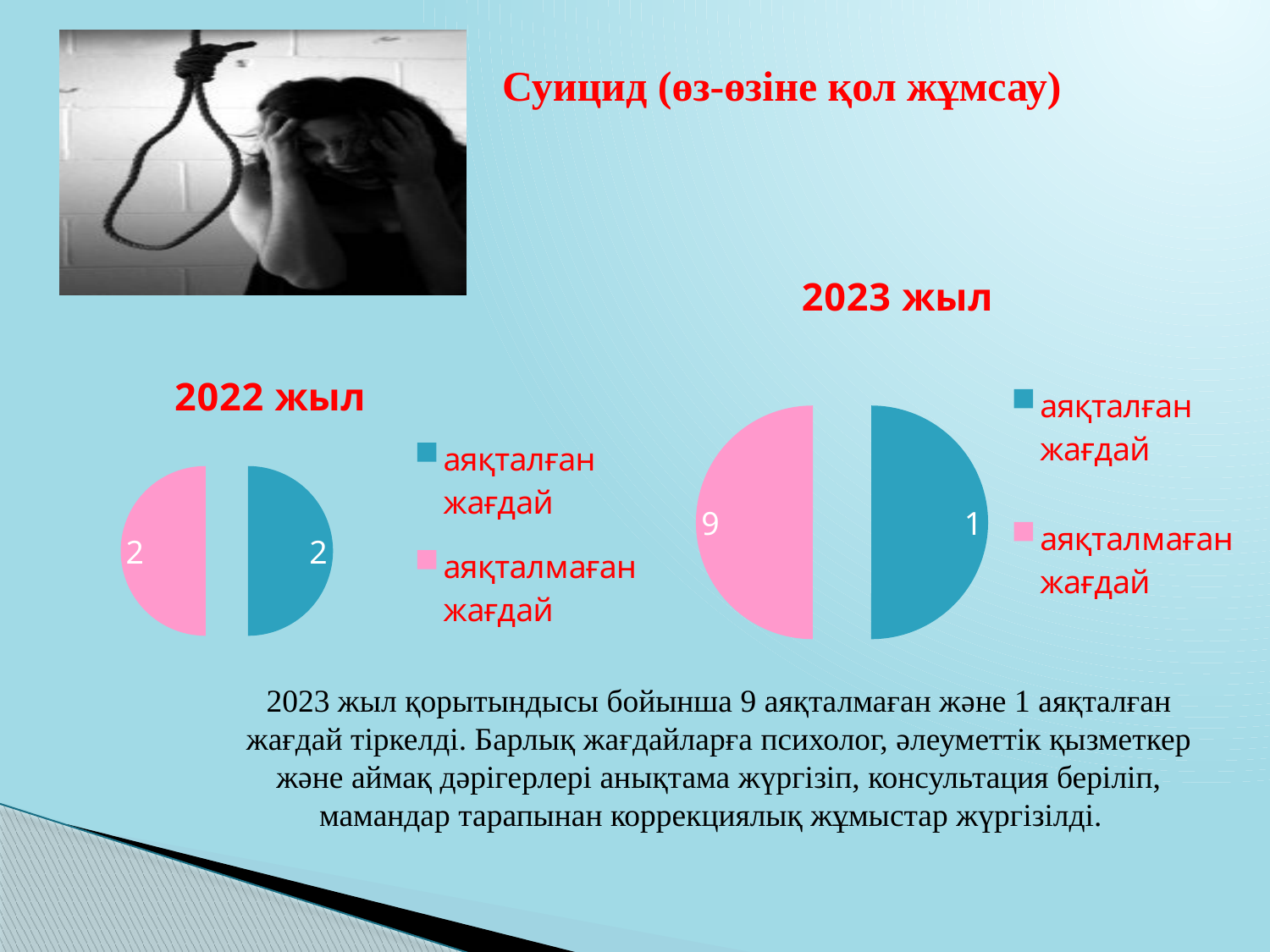
In the "2023 жыл" chart, what is the value for аяқталмаған жағдай? 9 How many slices does the "2022 жыл" chart have? 2 In the "2022 жыл" chart, what is the value for аяқталған жағдай? 2 In the "2023 жыл" chart, which is larger: аяқталған жағдай or аяқталмаған жағдай? аяқталмаған жағдай In the "2023 жыл" chart, what colour is the аяқталмаған жағдай slice? pink What kind of chart is the "2022 жыл" chart? pie chart In the "2022 жыл" chart, what share of the total does аяқталған жағдай represent? 50% In the "2023 жыл" chart, what is the value for аяқталған жағдай? 1 In the "2022 жыл" chart, what is the value for аяқталмаған жағдай? 2 In the "2023 жыл" chart, which category has the largest value? аяқталмаған жағдай What kind of chart is the "2023 жыл" chart? pie chart In the "2023 жыл" chart, what is the difference between аяқталмаған жағдай and аяқталған жағдай? 8